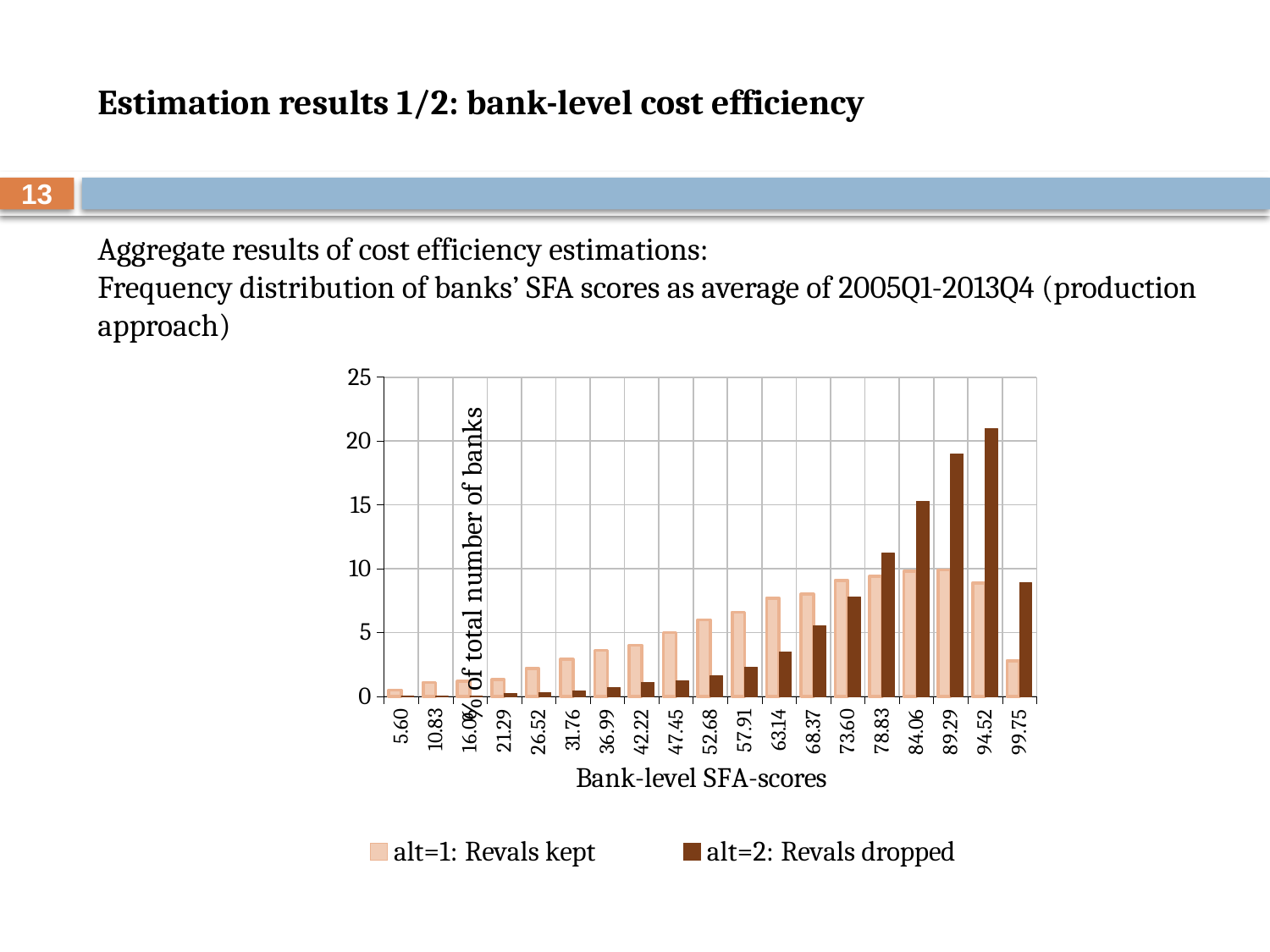
How many series does the legend list? 2 Is the value for alt=2: Revals dropped at 94.52 greater or less than 20? greater Is the value for alt=1: Revals kept at 99.75 greater or less than 5? less At the SFA-score 99.75, which series has the larger value, alt=1: Revals kept or alt=2: Revals dropped? alt=2: Revals dropped Do the values for alt=2: Revals dropped generally rise or fall from 5.60 to 94.52 along the x axis? rise For the series alt=2: Revals dropped, which SFA-score category has the highest value? 94.52 At the SFA-score 73.60, which series has the larger value, alt=1: Revals kept or alt=2: Revals dropped? alt=1: Revals kept What is the title of the x axis? Bank-level SFA-scores Is the value for alt=2: Revals dropped at 78.83 greater or less than 10? greater How many SFA-score categories are shown on the x axis? 19 What kind of chart is shown on the slide? bar chart